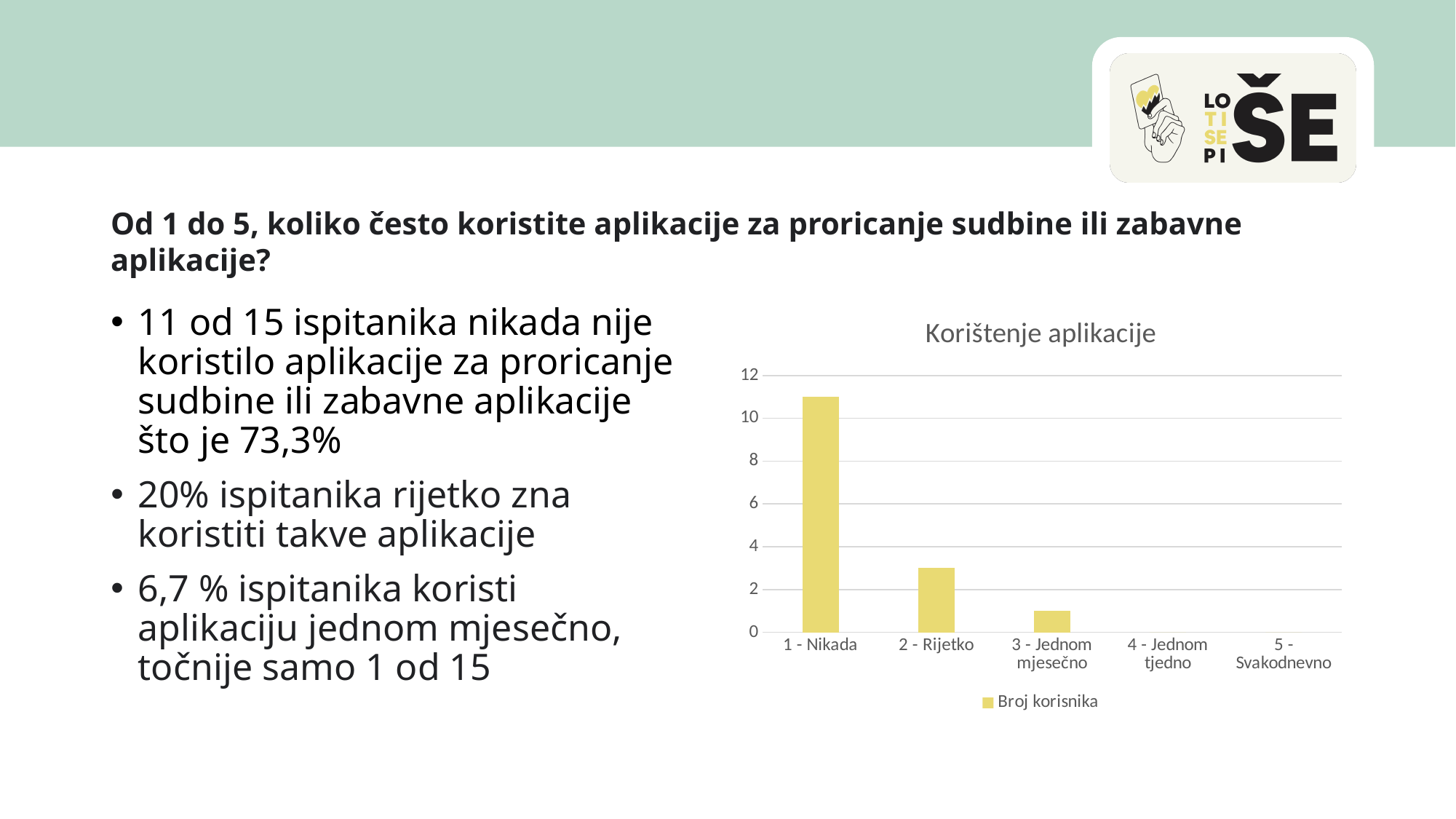
Which is larger, the value for 1 - Nikada or the value for 2 - Rijetko? 1 - Nikada What type of chart is shown on the slide? bar chart What is the name of the series in the chart legend? Broj korisnika Do the values rise or fall moving from 1 - Nikada to 5 - Svakodnevno along the x axis? fall How many categories are shown on the x axis of the chart? 5 What is the title of the chart? Korištenje aplikacije Which category has the highest value in the chart? 1 - Nikada How many series does the chart legend list? 1 What is the value for 4 - Jednom tjedno in the chart? 0 What is the value for 3 - Jednom mjesečno in the chart? 1 Is the value for 2 - Rijetko greater or less than 2? greater What is the value for 1 - Nikada in the chart? 11